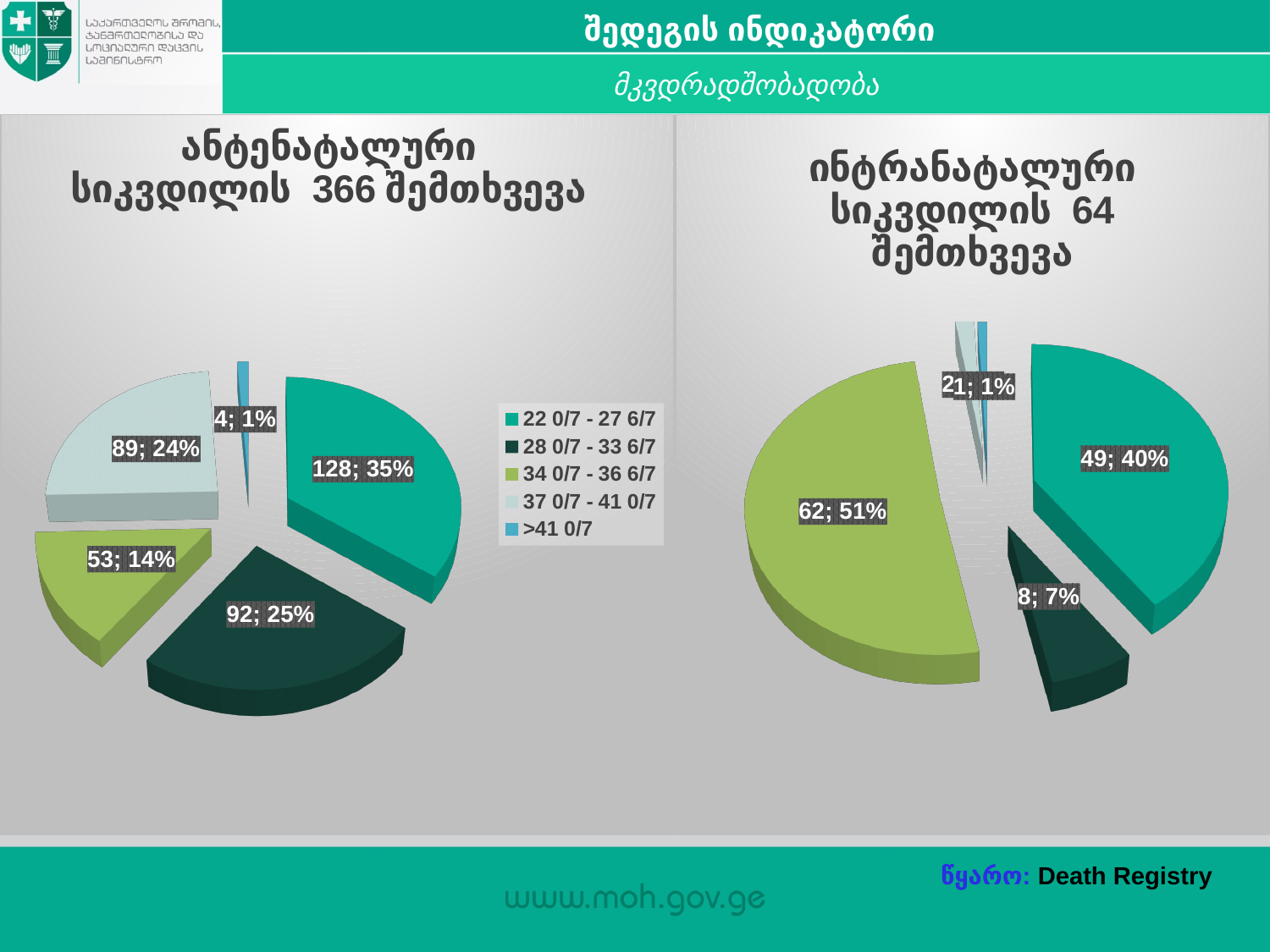
On the left pie chart, what value and share are shown for the 28 0/7 - 33 6/7 slice? 92; 25% On the right pie chart (ინტრანატალური სიკვდილის 64 შემთხვევა), what value and share are shown for the 34 0/7 - 36 6/7 slice? 62; 51% On the left pie chart, what value is shown for the 37 0/7 - 41 0/7 slice? 89 On the right pie chart, what value and share are shown for the 22 0/7 - 27 6/7 slice? 49; 40% On the left pie chart, what is the difference between the 22 0/7 - 27 6/7 value and the 28 0/7 - 33 6/7 value? 36 On the left pie chart, what share is shown for the 34 0/7 - 36 6/7 slice? 14% How many entries does the legend list? 5 On the left pie chart, which slice is the smallest? >41 0/7 On the right pie chart, which is larger: the 28 0/7 - 33 6/7 slice or the 22 0/7 - 27 6/7 slice? 22 0/7 - 27 6/7 On the left pie chart, which slice is the largest? 22 0/7 - 27 6/7 On the left pie chart (ანტენატალური სიკვდილის 366 შემთხვევა), what value and share are shown for the 22 0/7 - 27 6/7 slice? 128; 35% What kind of chart is used on the left side of the slide? Pie chart